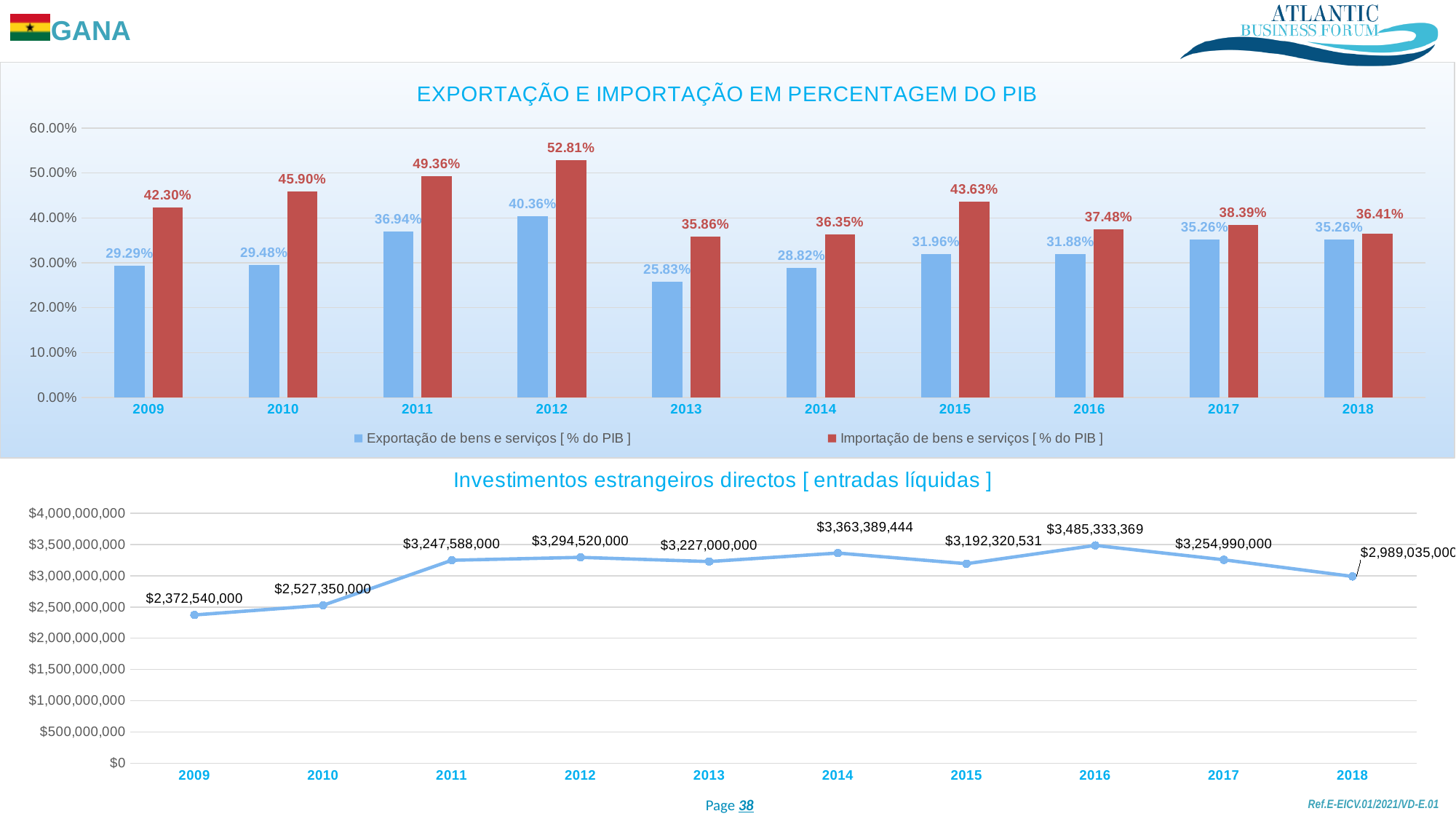
In the chart titled 'EXPORTAÇÃO E IMPORTAÇÃO EM PERCENTAGEM DO PIB', which year has the lowest Importação de bens e serviços value? 2013 In the chart titled 'EXPORTAÇÃO E IMPORTAÇÃO EM PERCENTAGEM DO PIB', how many series does the legend list? 2 In the chart titled 'EXPORTAÇÃO E IMPORTAÇÃO EM PERCENTAGEM DO PIB', what is the difference between Importação and Exportação in 2011? 12.42% In the chart titled 'Investimentos estrangeiros directos [ entradas líquidas ]', how many years are plotted? 10 In the chart titled 'Investimentos estrangeiros directos [ entradas líquidas ]', is the value for 2017 larger or smaller than the value for 2018? Larger In the chart titled 'EXPORTAÇÃO E IMPORTAÇÃO EM PERCENTAGEM DO PIB', what is the value of Exportação de bens e serviços for 2013? 25.83% In the chart titled 'Investimentos estrangeiros directos [ entradas líquidas ]', what is the value for 2016? $3,485,333,369 In the chart titled 'EXPORTAÇÃO E IMPORTAÇÃO EM PERCENTAGEM DO PIB', what is the value of Importação de bens e serviços for 2012? 52.81% In the chart titled 'EXPORTAÇÃO E IMPORTAÇÃO EM PERCENTAGEM DO PIB', which year has the highest Exportação de bens e serviços value? 2012 In the chart titled 'Investimentos estrangeiros directos [ entradas líquidas ]', what kind of chart is shown? Line chart In the chart titled 'EXPORTAÇÃO E IMPORTAÇÃO EM PERCENTAGEM DO PIB', what kind of chart is shown? Bar chart In the chart titled 'Investimentos estrangeiros directos [ entradas líquidas ]', which year has the lowest value? 2009